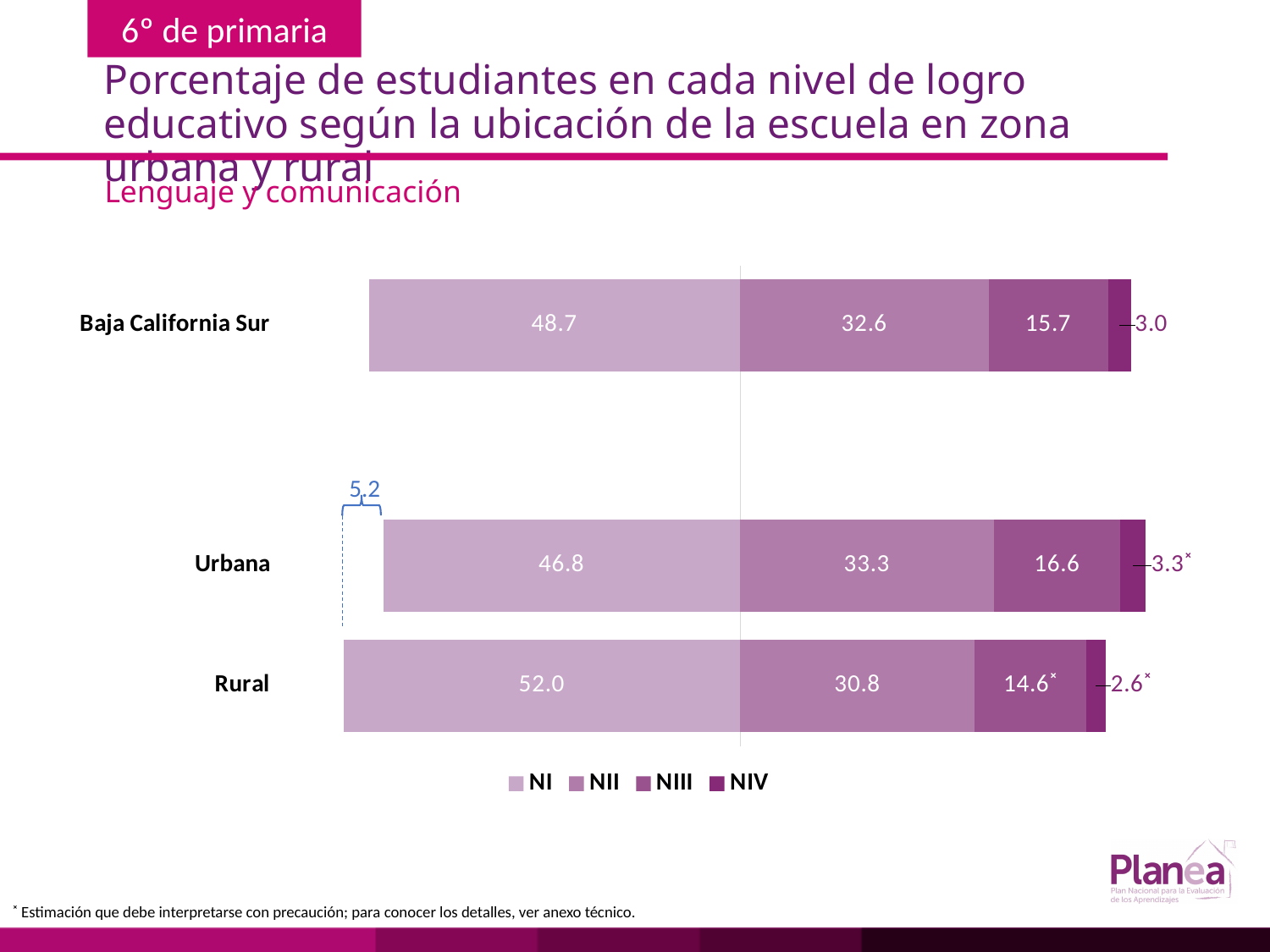
How many series does the legend list? 4 What is the NI value for Baja California Sur? 48.7 What is the NI value for Rural? 52.0 Which category has the lowest NIII value? Rural What type of chart is shown on the slide? stacked bar chart What is the NII value for Urbana? 33.3 Which is larger, the NII value for Baja California Sur or the NII value for Rural? Baja California Sur What is the difference between the NI values for Rural and Urbana? 5.2 What is the NIII value for Baja California Sur? 15.7 How many categories are shown on the chart? 3 What is the NIV value for Baja California Sur? 3.0 Which category has the highest NI value? Rural